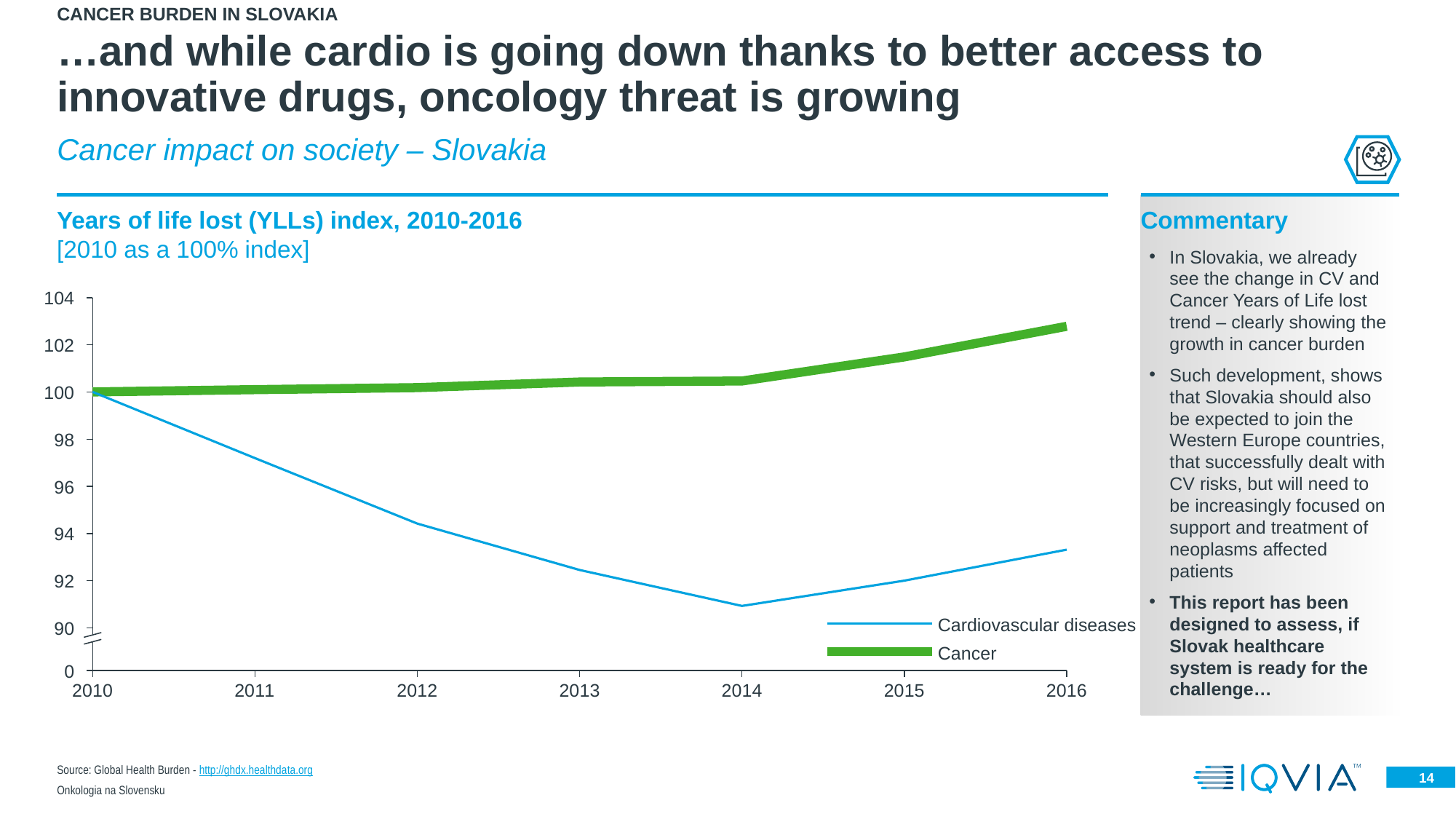
Is the value for Cardiovascular diseases in 2014 greater or less than 92? less Is the value for Cardiovascular diseases in 2016 greater or less than 92? greater Which series is drawn with the thick green line? Cancer How many series does the chart legend list? 2 How many years are plotted along the x axis of the chart? 7 Is the value for Cardiovascular diseases in 2012 greater or less than 96? less Which series has the higher value in 2016, Cancer or Cardiovascular diseases? Cancer Does the Cancer line rise or fall from 2014 to 2016? rise Does the Cardiovascular diseases line rise or fall from 2010 to 2014? fall What is the index value for Cardiovascular diseases in 2010? 100 What kind of chart is shown on the slide? line chart